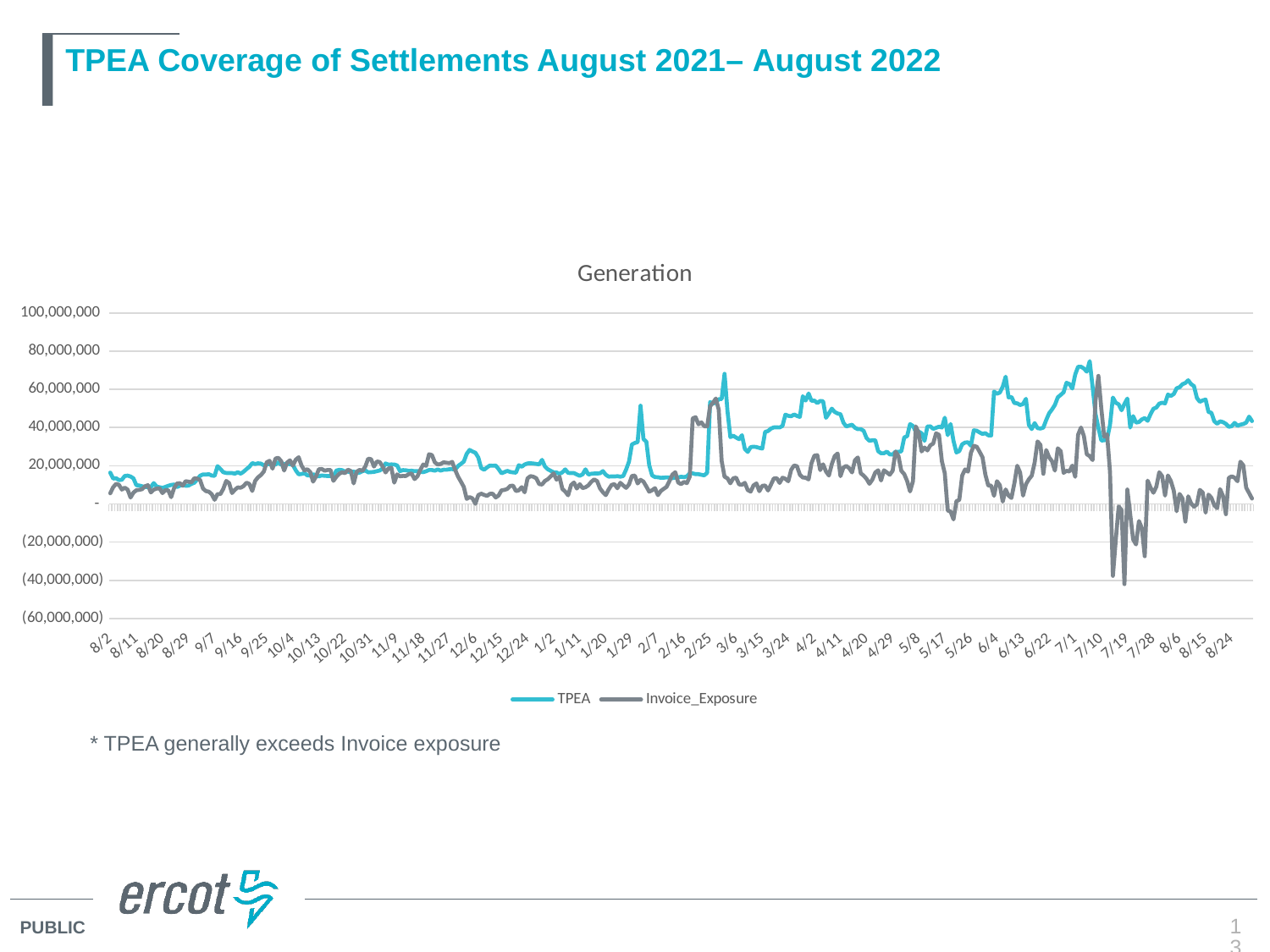
Around 7/19, which series has the higher value, TPEA or Invoice_Exposure? TPEA Which series reaches the lowest value on the chart? Invoice_Exposure What is the title of the chart? Generation Does the TPEA series ever exceed 80,000,000 on the chart? No Is the value of Invoice_Exposure around 2/25 greater or less than 40,000,000? greater Is the lowest value of Invoice_Exposure around 7/19 greater or less than (20,000,000)? less How many series does the legend list? 2 Which two series are listed in the legend? TPEA and Invoice_Exposure What kind of chart is shown on the slide? Line chart